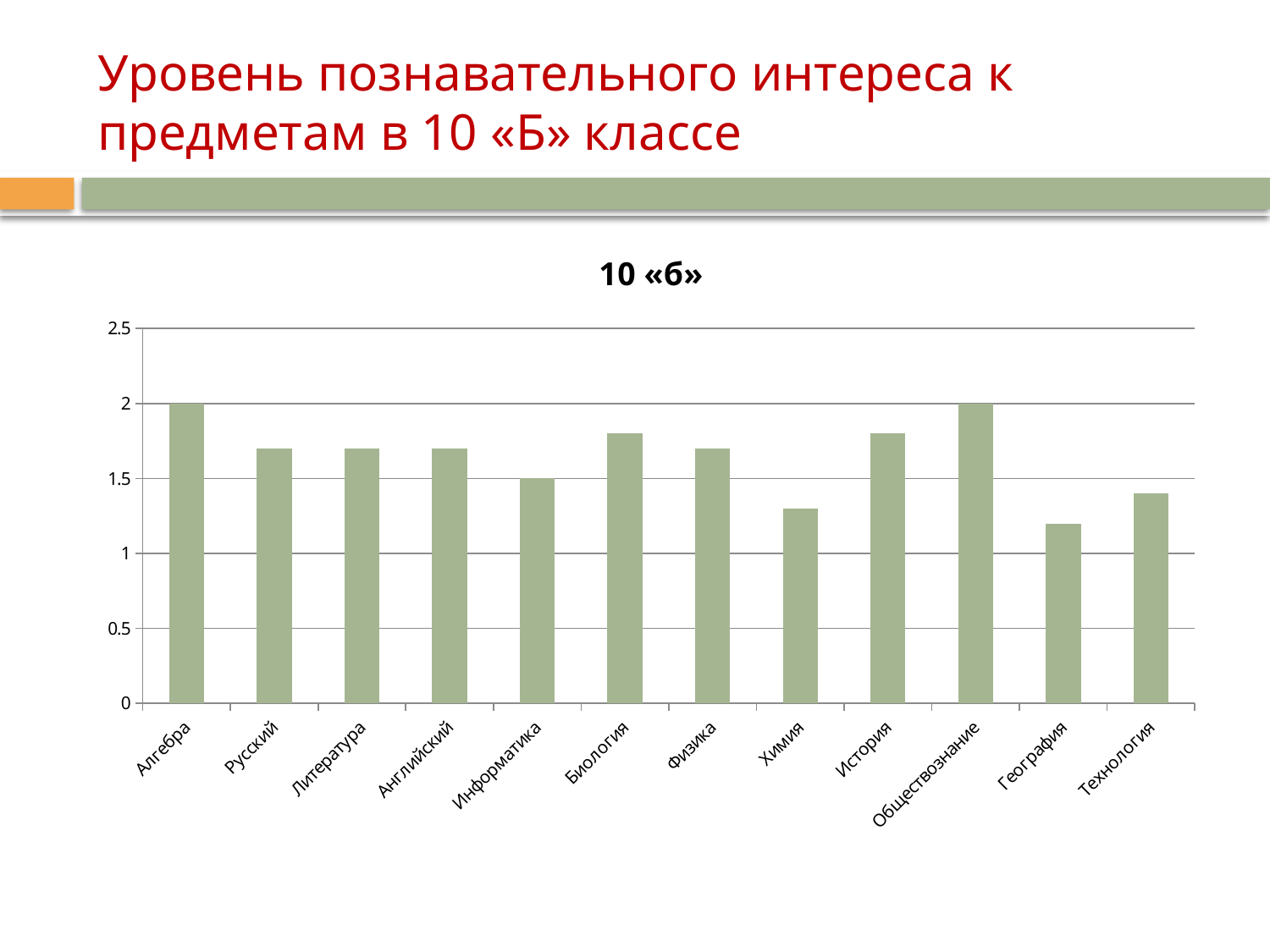
Is the value for Химия greater or less than 1.5? less What is the value for Алгебра? 2 Which has the larger value, Алгебра or Химия? Алгебра What is the value for Информатика? 1.5 What is the chart's title? 10 «б» What type of chart is shown on the slide? bar chart How many subjects (categories) are plotted on the chart? 12 Is the value for География greater or less than 1.5? less What is the value for Обществознание? 2 What is the difference between the values for Алгебра and Информатика? 0.5 Which has the larger value, Биология or Технология? Биология Is the value for Русский greater or less than 1.5? greater